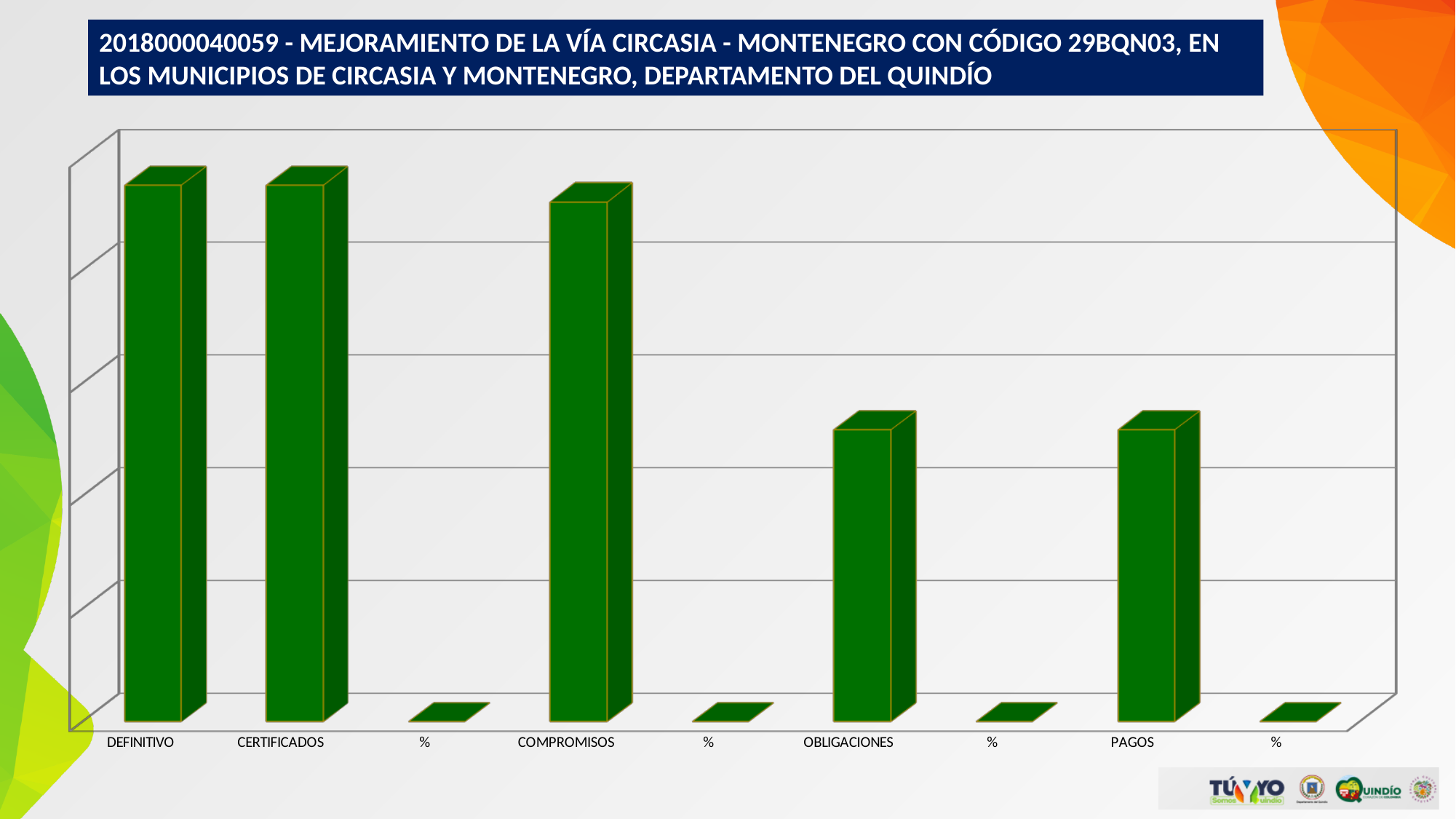
How many categories are shown along the x axis of the chart? 9 Which bar is taller, PAGOS or DEFINITIVO? DEFINITIVO What is the label of the first category on the x axis? DEFINITIVO Which bar is taller, OBLIGACIONES or COMPROMISOS? COMPROMISOS Which bar is taller, DEFINITIVO or OBLIGACIONES? DEFINITIVO What kind of chart is shown on the slide? bar chart What colour are the bars in the chart? green